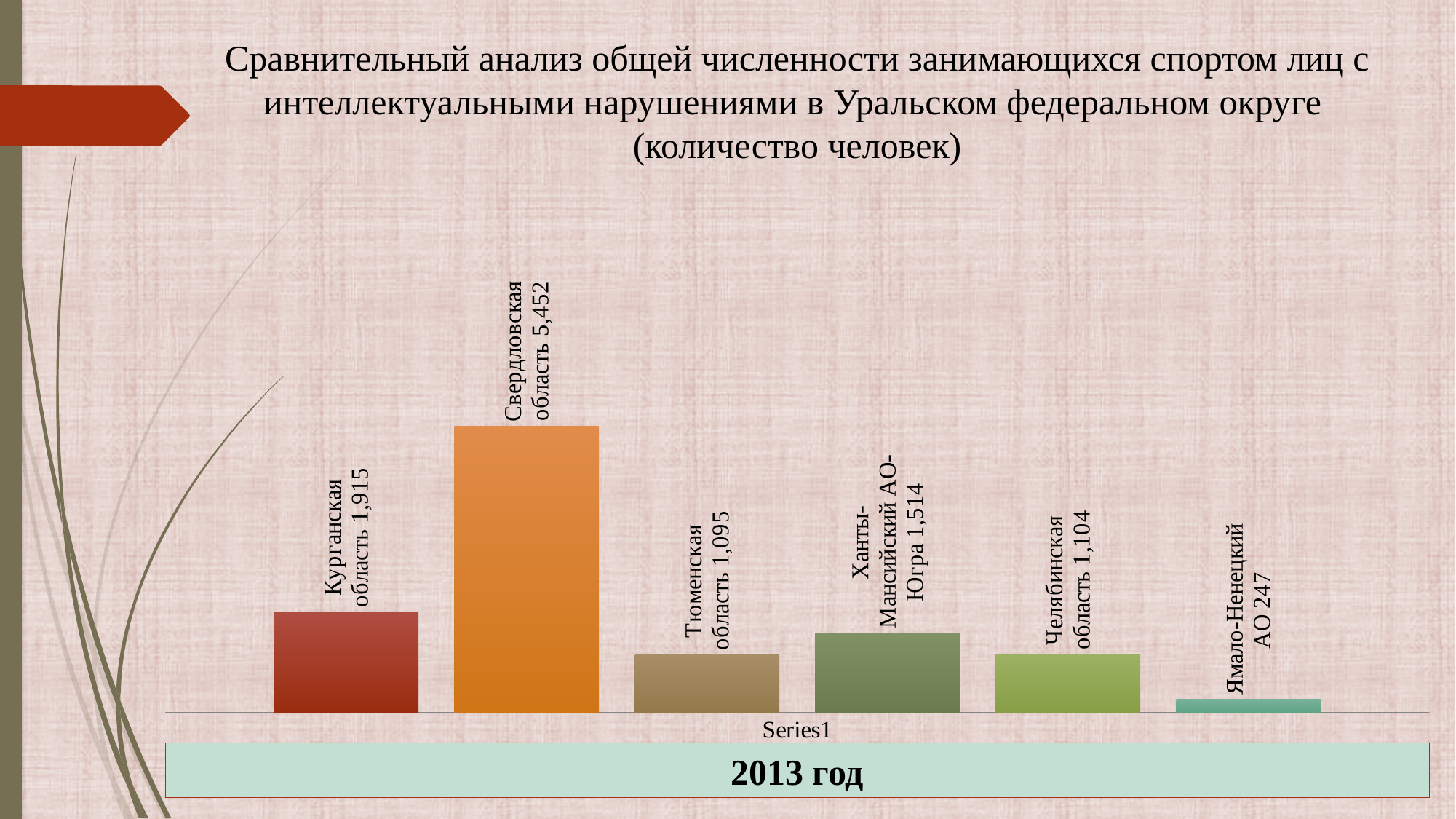
What is the value for Ханты-Мансийский АО-Югра? 1,514 Which is larger, the value for Курганская область or the value for Ханты-Мансийский АО-Югра? Курганская область What kind of chart is shown on the slide? bar chart What is the value for Ямало-Ненецкий АО? 247 How many regions are shown in the chart? 6 What is the difference between the values for Челябинская область and Тюменская область? 9 Which region has the highest value? Свердловская область What is the value for Курганская область? 1,915 Which year does the chart refer to, according to the label below it? 2013 год Which region has the lowest value? Ямало-Ненецкий АО What is the difference between the values for Свердловская область and Курганская область? 3,537 What is the value for Свердловская область? 5,452